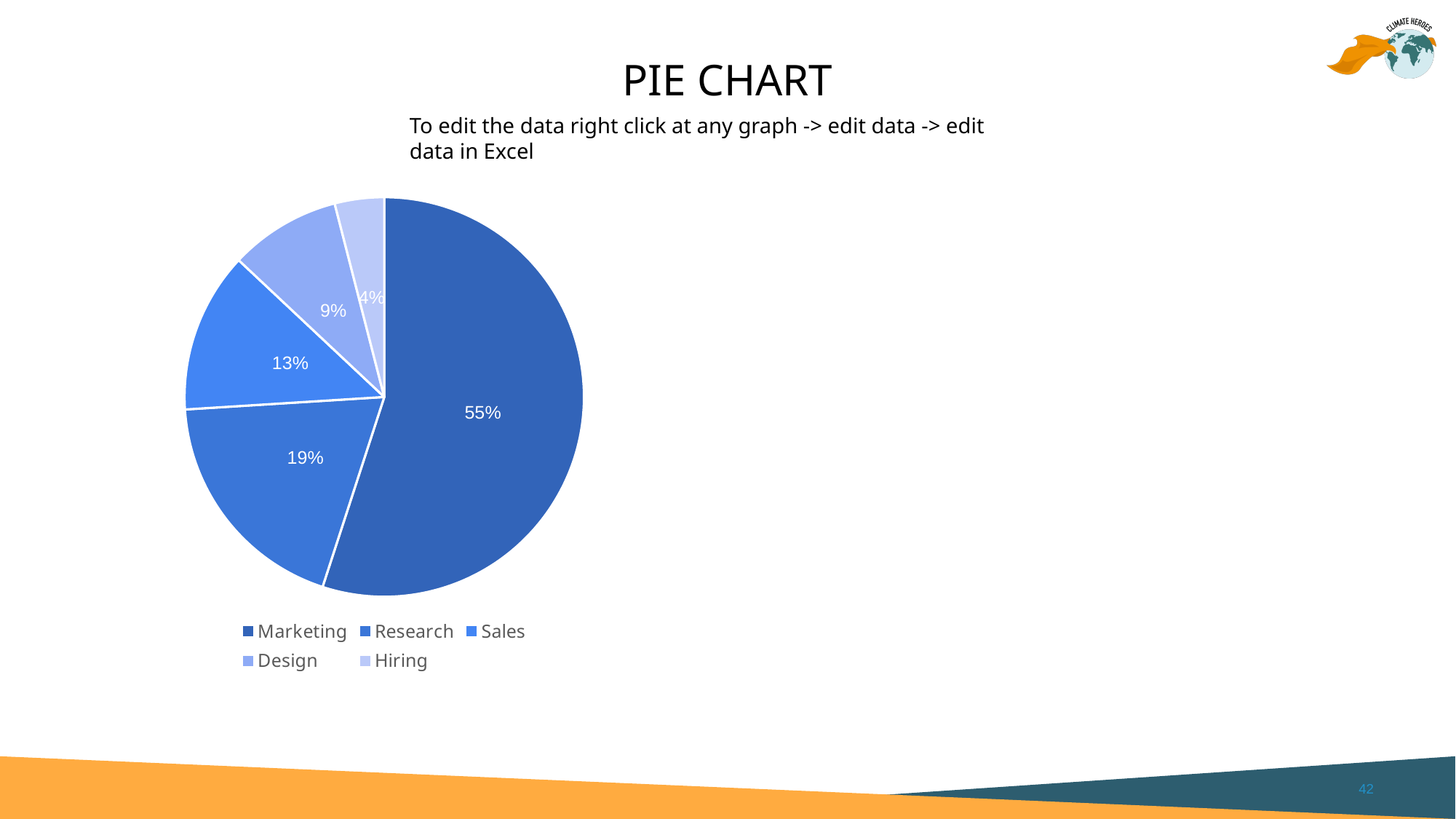
What share of the pie does Marketing have? 55% Which slice is larger, Sales or Design? Sales What is the title of the slide containing the chart? PIE CHART How many categories does the pie chart have? 5 What kind of chart is shown on the slide? pie chart Which category has the largest slice of the pie? Marketing Which category has the smallest slice of the pie? Hiring What share of the pie does Design have? 9% What share of the pie does Hiring have? 4% What is the difference in percentage points between the Marketing and Research slices? 36